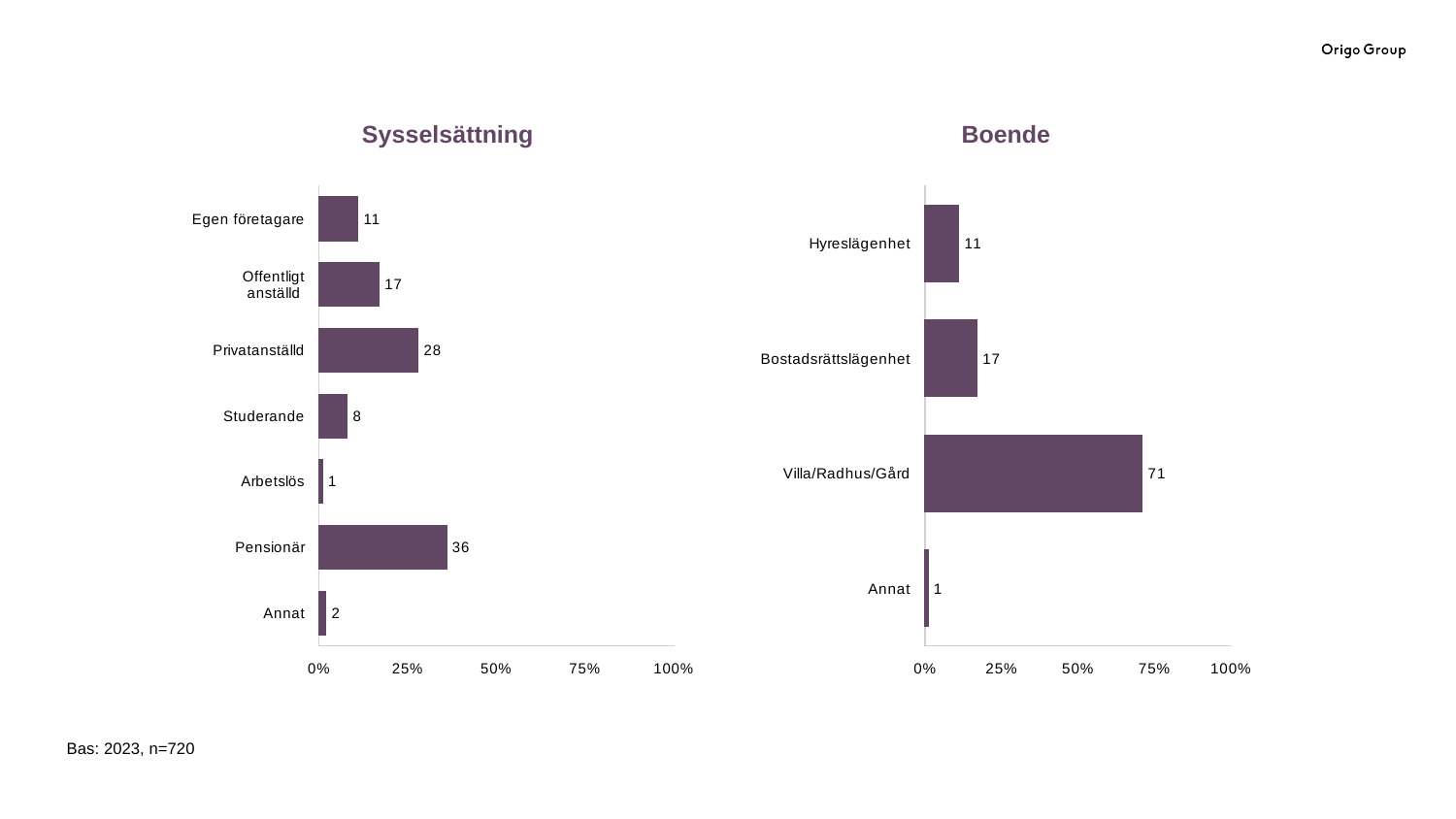
In the Sysselsättning chart, what is the value for Privatanställd? 28 In the Boende chart, what is the difference between the values for Villa/Radhus/Gård and Hyreslägenhet? 60 In the Boende chart, which category has the highest value? Villa/Radhus/Gård In the Sysselsättning chart, is the value for Offentligt anställd greater or less than 25%? less In the Boende chart, what is the value for Villa/Radhus/Gård? 71 What kind of chart is the Boende chart? bar chart In the Sysselsättning chart, how many categories are shown? 7 In the Sysselsättning chart, which category has the lowest value? Arbetslös In the Boende chart, which is larger, Hyreslägenhet or Bostadsrättslägenhet? Bostadsrättslägenhet In the Sysselsättning chart, which category has the highest value? Pensionär In the Sysselsättning chart, what is the difference between the values for Pensionär and Privatanställd? 8 In the Boende chart, how many categories are shown? 4